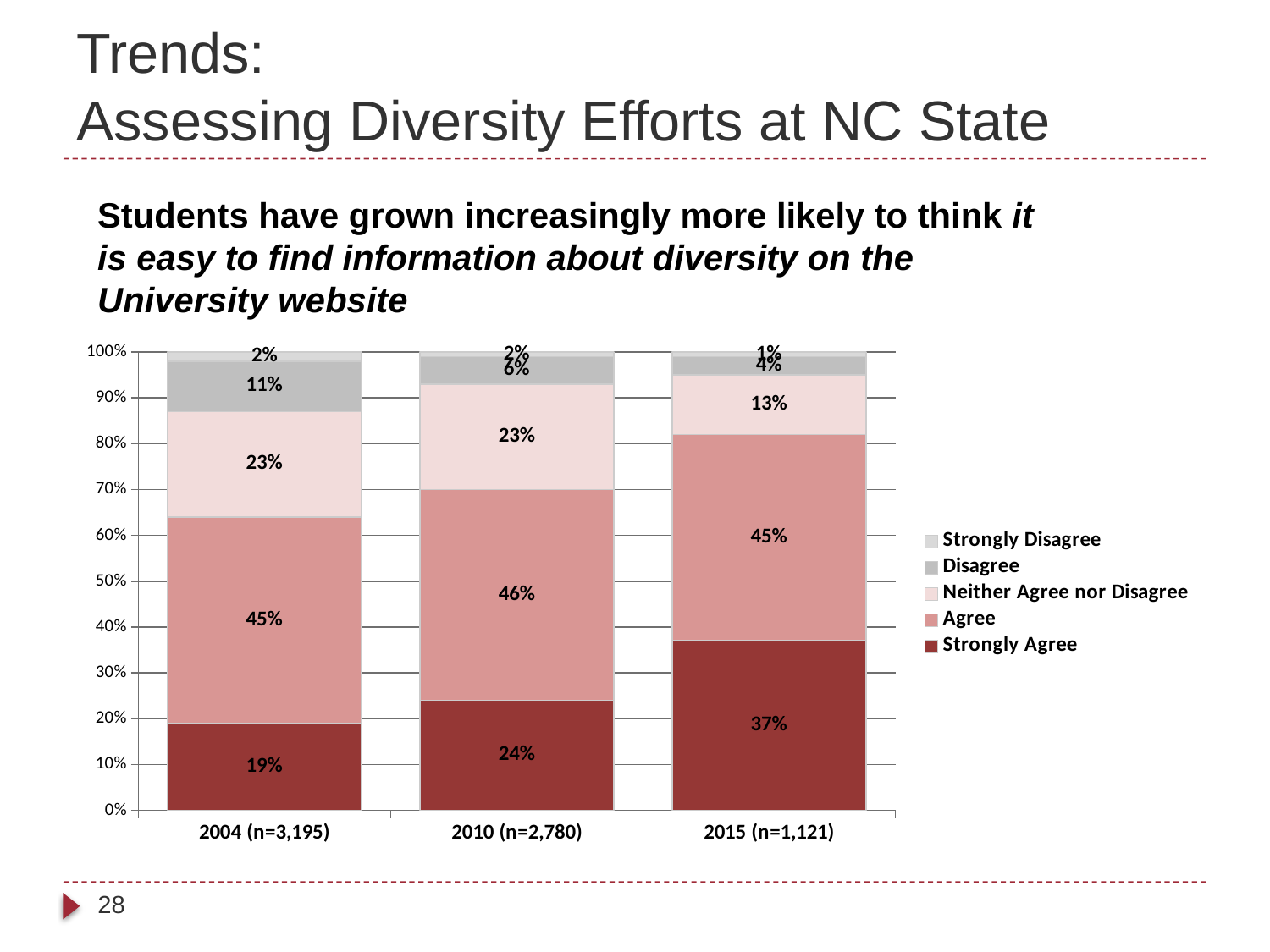
What percentage of students in 2004 (n=3,195) selected Disagree? 11% How many survey years are shown on the x axis? 3 What percentage of students in 2015 (n=1,121) selected Neither Agree nor Disagree? 13% What percentage of students in 2010 (n=2,780) selected Agree? 46% Does the Strongly Agree share rise or fall from 2004 to 2015? Rises Which year has the larger Neither Agree nor Disagree share, 2004 or 2015? 2004 (n=3,195) Which survey year has the highest Strongly Agree percentage? 2015 (n=1,121) How many response categories does the legend list? 5 What percentage of students in 2004 (n=3,195) selected Strongly Agree? 19% What kind of chart is shown on the slide? Stacked bar chart Which survey year has the lowest Strongly Agree percentage? 2004 (n=3,195) By how many percentage points did the Strongly Agree share increase from 2004 to 2015? 18 percentage points